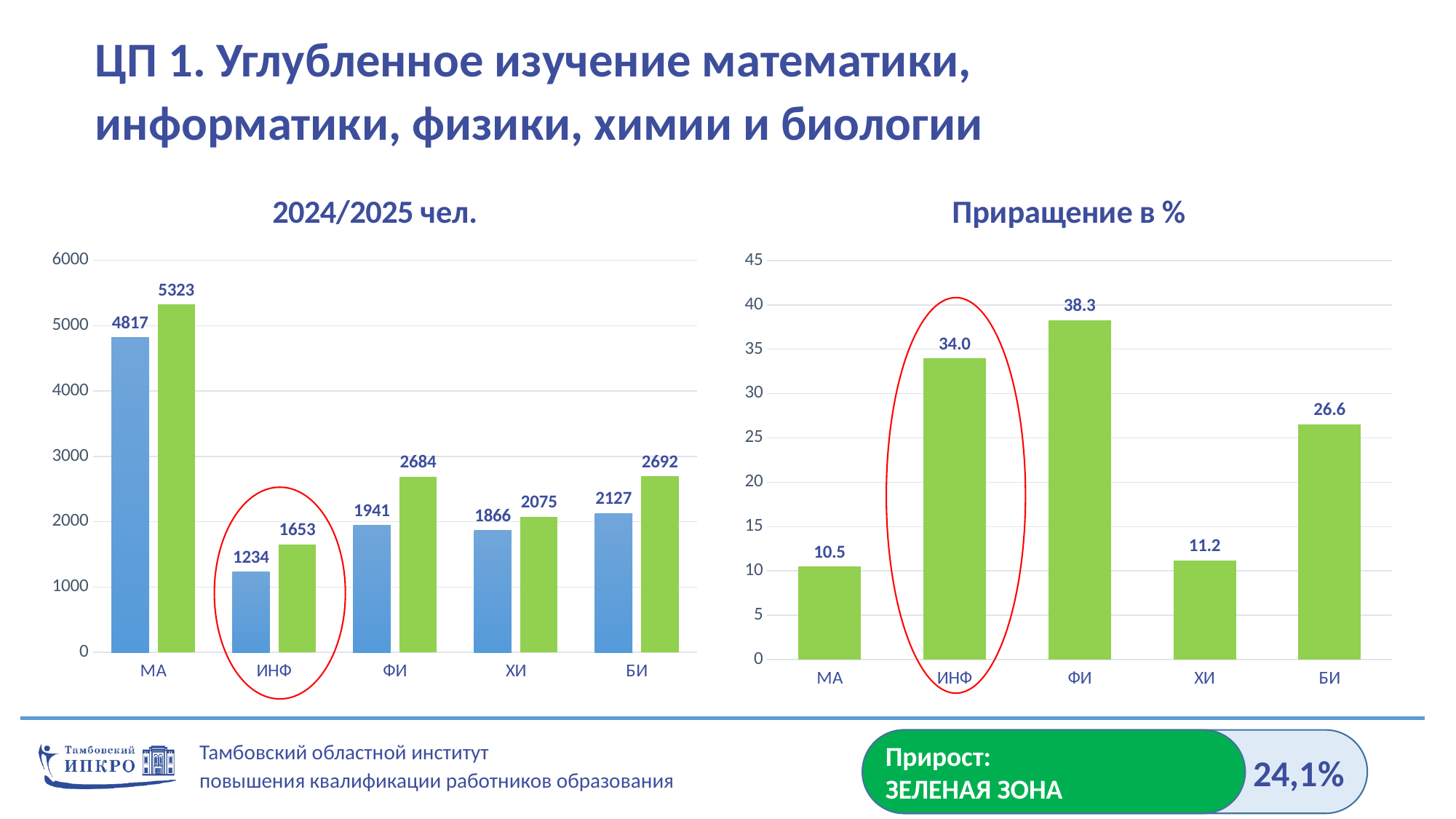
In the chart titled "Приращение в %", which category has the highest value? ФИ In the chart titled "Приращение в %", what is the value for ФИ? 38.3 In the chart titled "Приращение в %", how many categories are shown on the x axis? 5 In the chart titled "2024/2025 чел.", what is the difference between the green and blue bars for ФИ? 743 In the chart titled "2024/2025 чел.", what is the value of the blue bar for ИНФ? 1234 In the chart titled "2024/2025 чел.", which category has the lowest blue bar? ИНФ In the chart titled "2024/2025 чел.", what is the value of the green bar for МА? 5323 In the chart titled "2024/2025 чел.", which is larger: the green bar for ХИ or the green bar for БИ? БИ In the chart titled "Приращение в %", what is the difference between the values for ФИ and ИНФ? 4.3 What type of chart is the chart titled "Приращение в %"? bar chart In the chart titled "Приращение в %", which category has the lowest value? МА In the chart titled "2024/2025 чел.", which category is circled in red? ИНФ